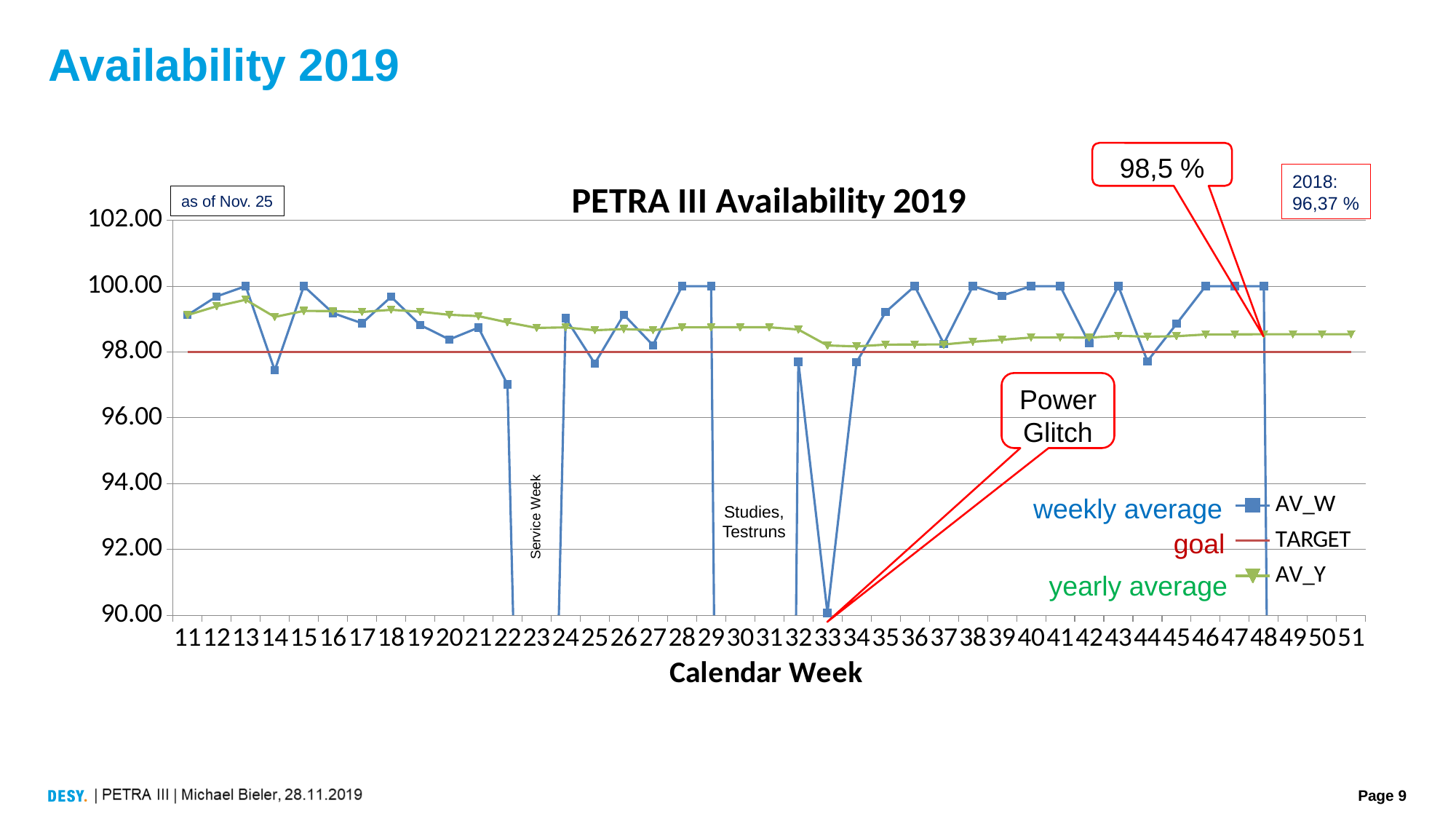
What is the x-axis title of the chart? Calendar Week Is the AV_W value for calendar week 14 greater or less than 98.00? less What availability value is given for 2018 on the slide? 96,37 % What yearly average value is highlighted in the callout at the end of the AV_Y line? 98,5 % How many series does the chart legend list? 3 Which has the larger AV_W value, calendar week 25 or calendar week 26? calendar week 26 What is the AV_W value for calendar week 28? 100.00 What is the title of the chart? PETRA III Availability 2019 At what value does the TARGET line sit on the y axis? 98.00 How many calendar weeks are labelled on the x axis? 41 What kind of chart is shown on the slide? line chart